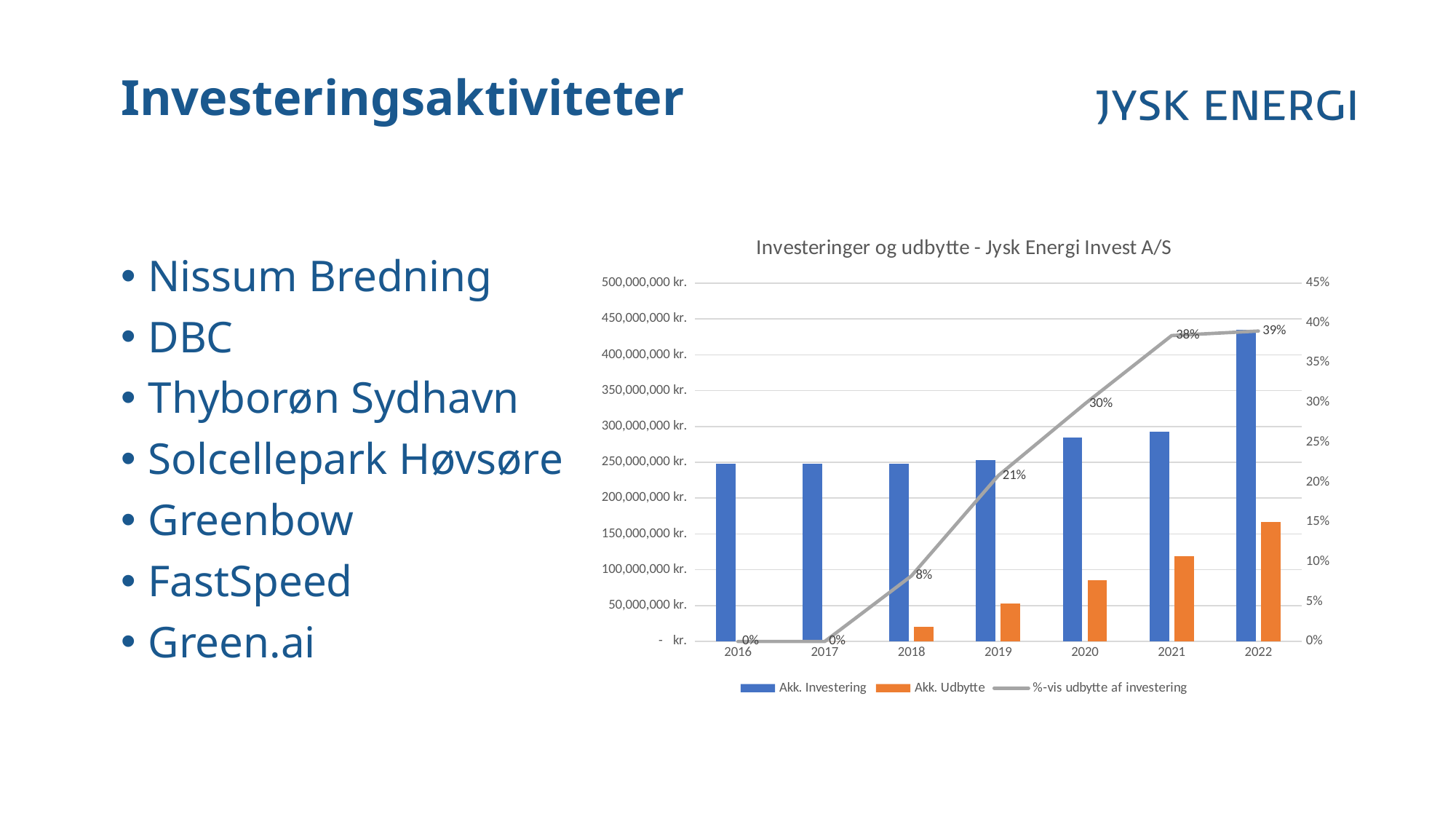
How many series does the legend list? 3 What is the value of the '%-vis udbytte af investering' line for 2022? 39% What is the value of the '%-vis udbytte af investering' line for 2019? 21% How many years are shown on the x axis? 7 Is the 'Akk. Investering' value for 2022 greater or less than 400,000,000 kr.? greater Is the 'Akk. Udbytte' value for 2022 greater or less than 150,000,000 kr.? greater What is the difference between the '%-vis udbytte af investering' values for 2021 and 2019? 17% In which year does the '%-vis udbytte af investering' line reach its highest value? 2022 What is the title of the chart? Investeringer og udbytte - Jysk Energi Invest A/S What is the value of the '%-vis udbytte af investering' line for 2018? 8% Does the '%-vis udbytte af investering' line rise or fall from 2016 to 2022? rise What kind of chart is shown on the slide? bar chart with a line